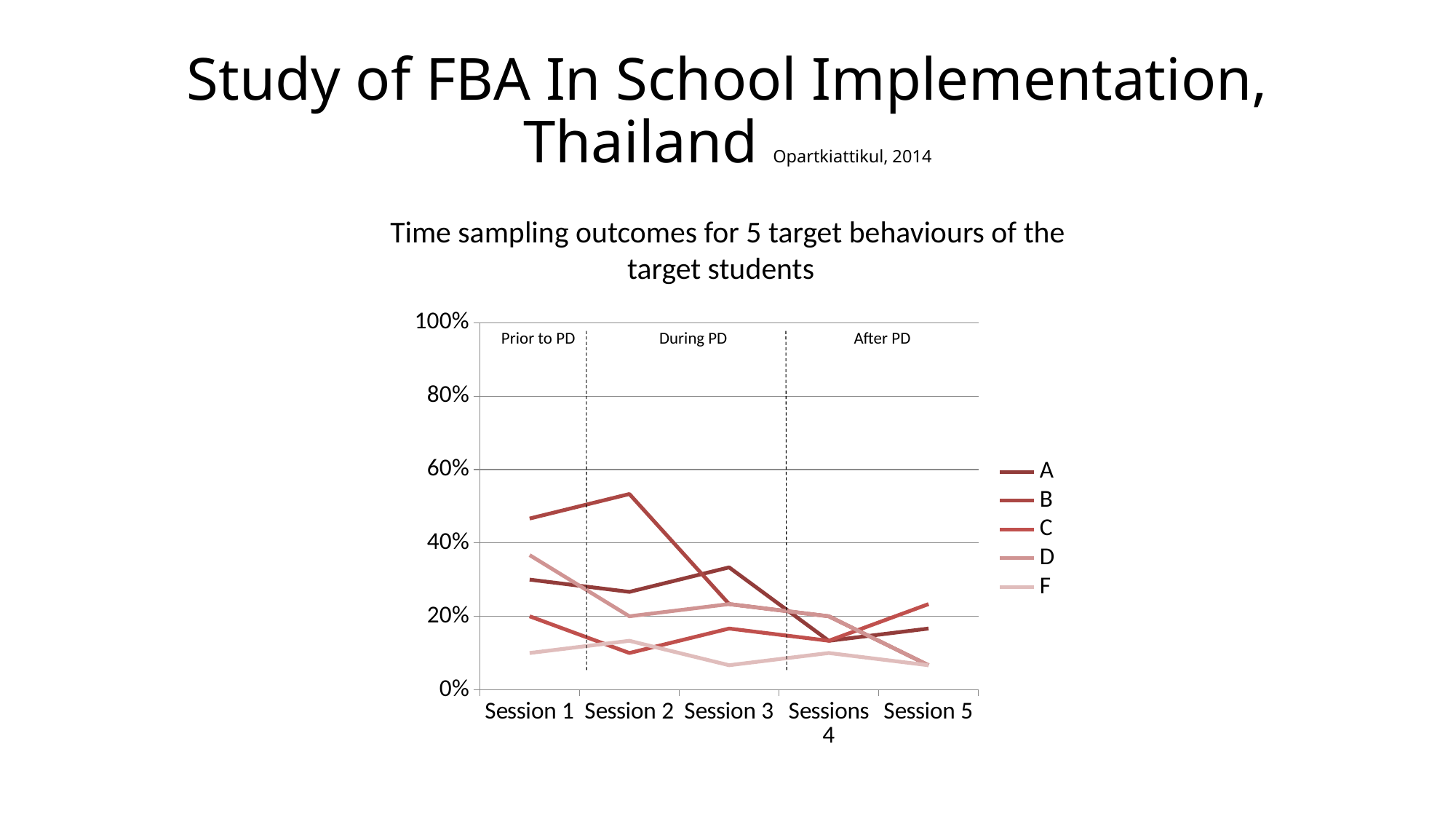
Which phase label appears above Session 1? Prior to PD What is the title of the chart? Time sampling outcomes for 5 target behaviours of the target students Which series has the lowest value at Session 1? F Is the value for series A at Session 1 greater or less than 20%? greater How many sessions are shown along the x axis? 5 At which session does the highest plotted value on the chart occur? Session 2 Is the value for series D at Session 1 greater or less than 20%? greater Is the value for series D at Session 5 greater or less than 20%? less What kind of chart is shown on the slide? line chart How many series does the legend list? 5 Does series D rise or fall overall from Session 1 to Session 5? fall